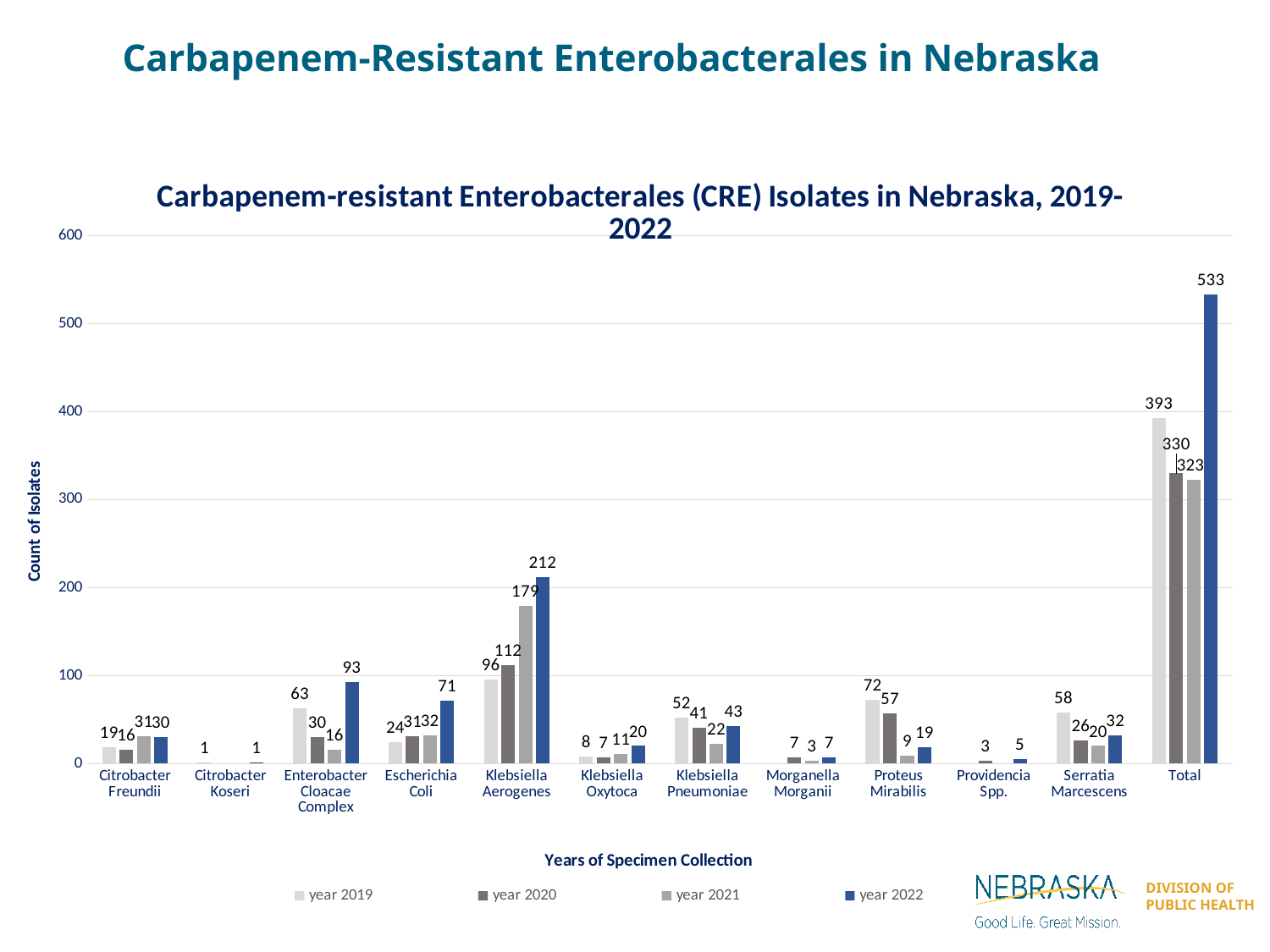
What is the total count of isolates for year 2022? 533 Is the year 2022 count for Escherichia Coli greater or less than 100? less How many series does the legend list? 4 Which is larger for Proteus Mirabilis: the year 2019 count or the year 2020 count? year 2019 What is the difference between the year 2022 and year 2019 counts for Klebsiella Aerogenes? 116 What is the count of Enterobacter Cloacae Complex isolates for year 2019? 63 What is the label of the y axis? Count of Isolates How many Klebsiella Aerogenes isolates were counted in year 2021? 179 How many categories are shown on the x axis, including Total? 12 What kind of chart is shown on the slide? bar chart Which year has the highest total count of isolates? year 2022 Which year has the lowest total count of isolates? year 2021